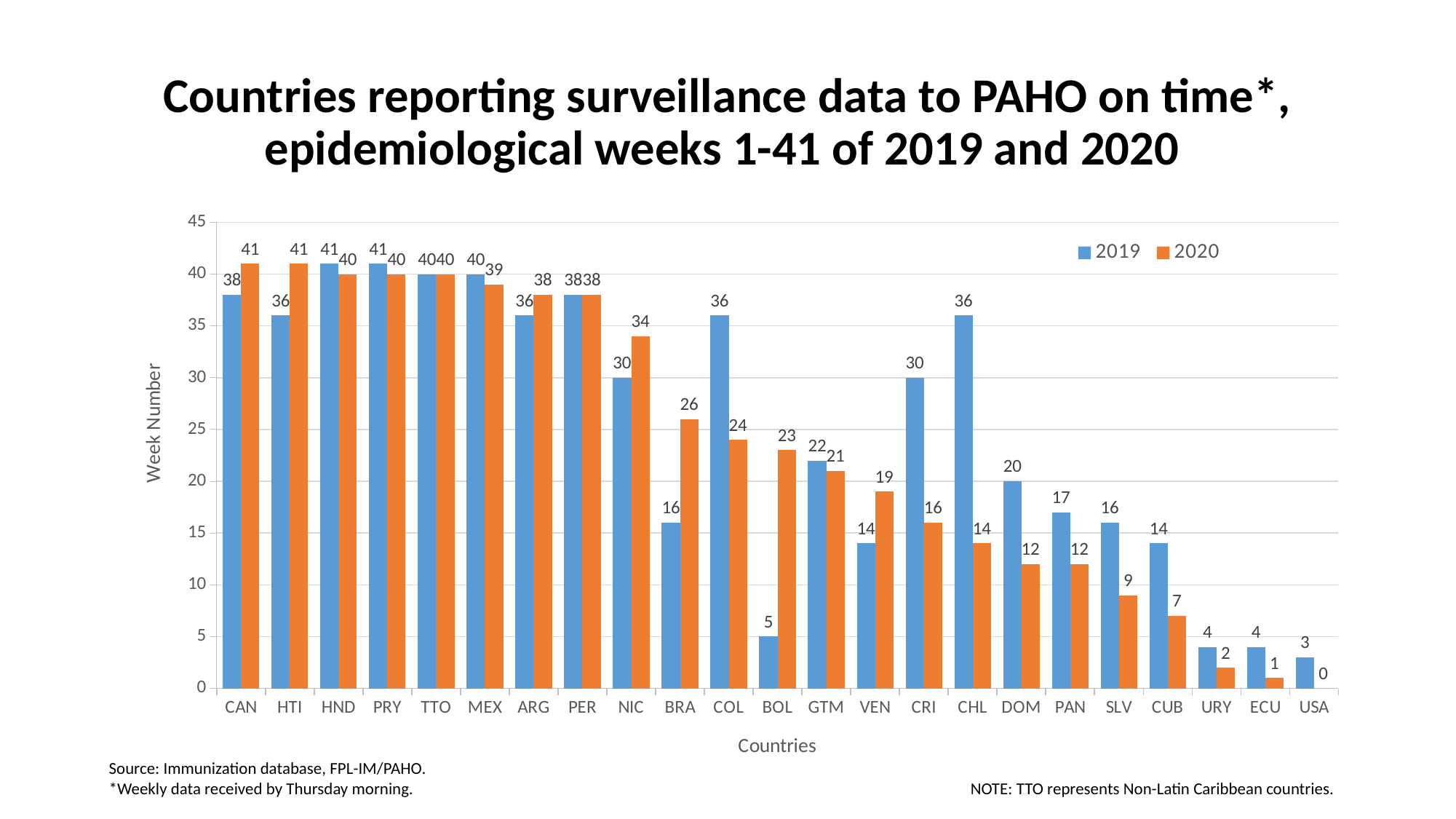
What kind of chart is shown on the slide? bar chart Which country has the highest 2020 value among CHL, DOM and PAN? CHL How many series does the legend list? 2 What is the 2020 value for BRA? 26 Which is larger for COL, the 2019 value or the 2020 value? 2019 How many countries are shown on the x axis? 23 What is the 2020 value for USA? 0 What is the 2019 value for BOL? 5 What is the difference between the 2019 and 2020 values for CHL? 22 Which country has the lowest 2019 value? USA Is the 2020 value for NIC greater or less than 30? greater What is the label of the y axis? Week Number